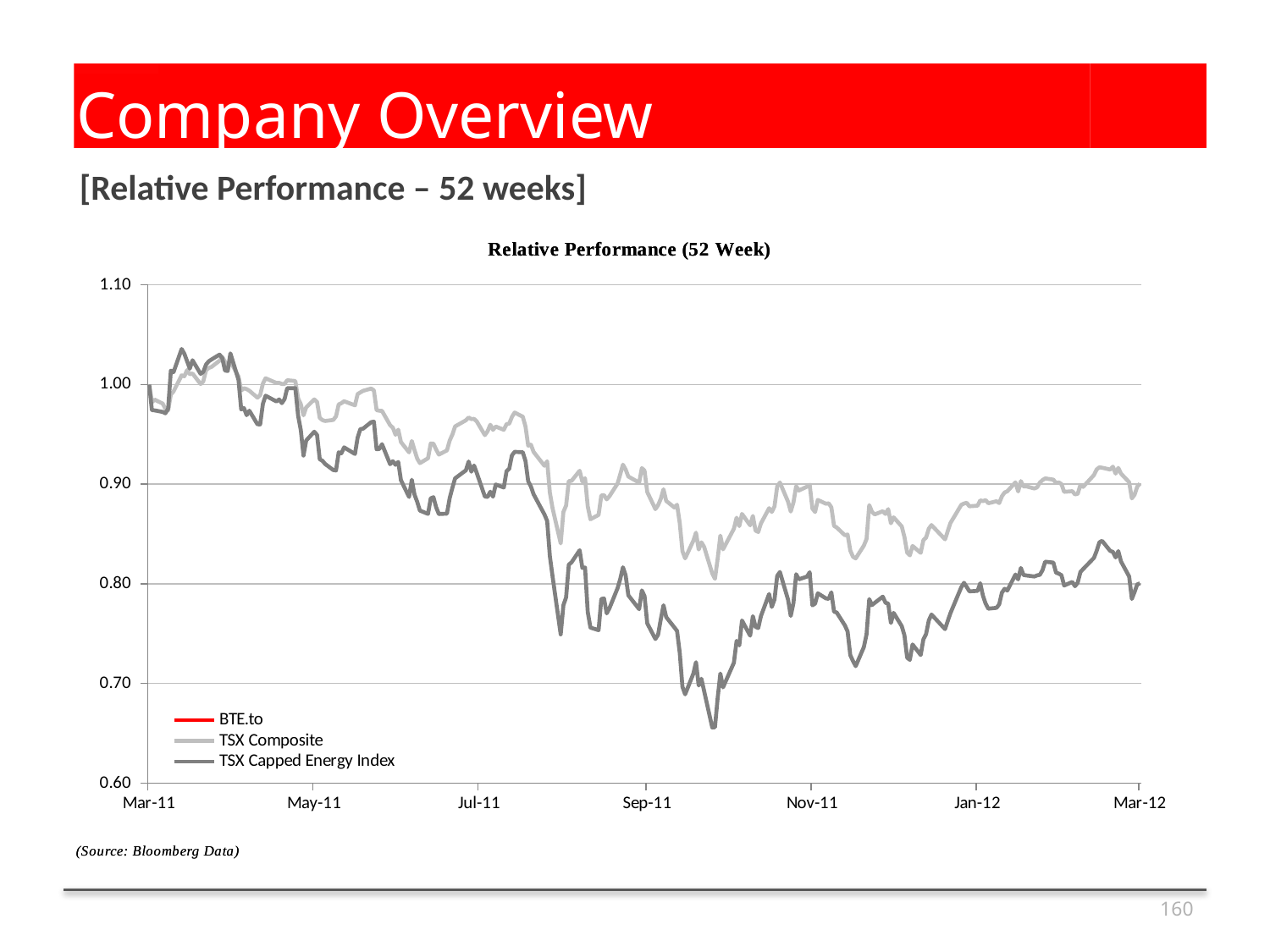
At Mar-12, which is higher: the TSX Composite or the TSX Capped Energy Index? TSX Composite Which series is shown in red in the legend? BTE.to What kind of chart is shown on the slide? line chart Is the value of the TSX Composite at Jul-11 greater or less than 0.90? greater Does the TSX Capped Energy Index line rise or fall overall from Mar-11 to Mar-12? fall How many series does the legend list? 3 How many date labels are shown on the x axis? 7 Is the lowest value of the TSX Capped Energy Index line greater or less than 0.70? less What is the title of the chart? Relative Performance (52 Week)